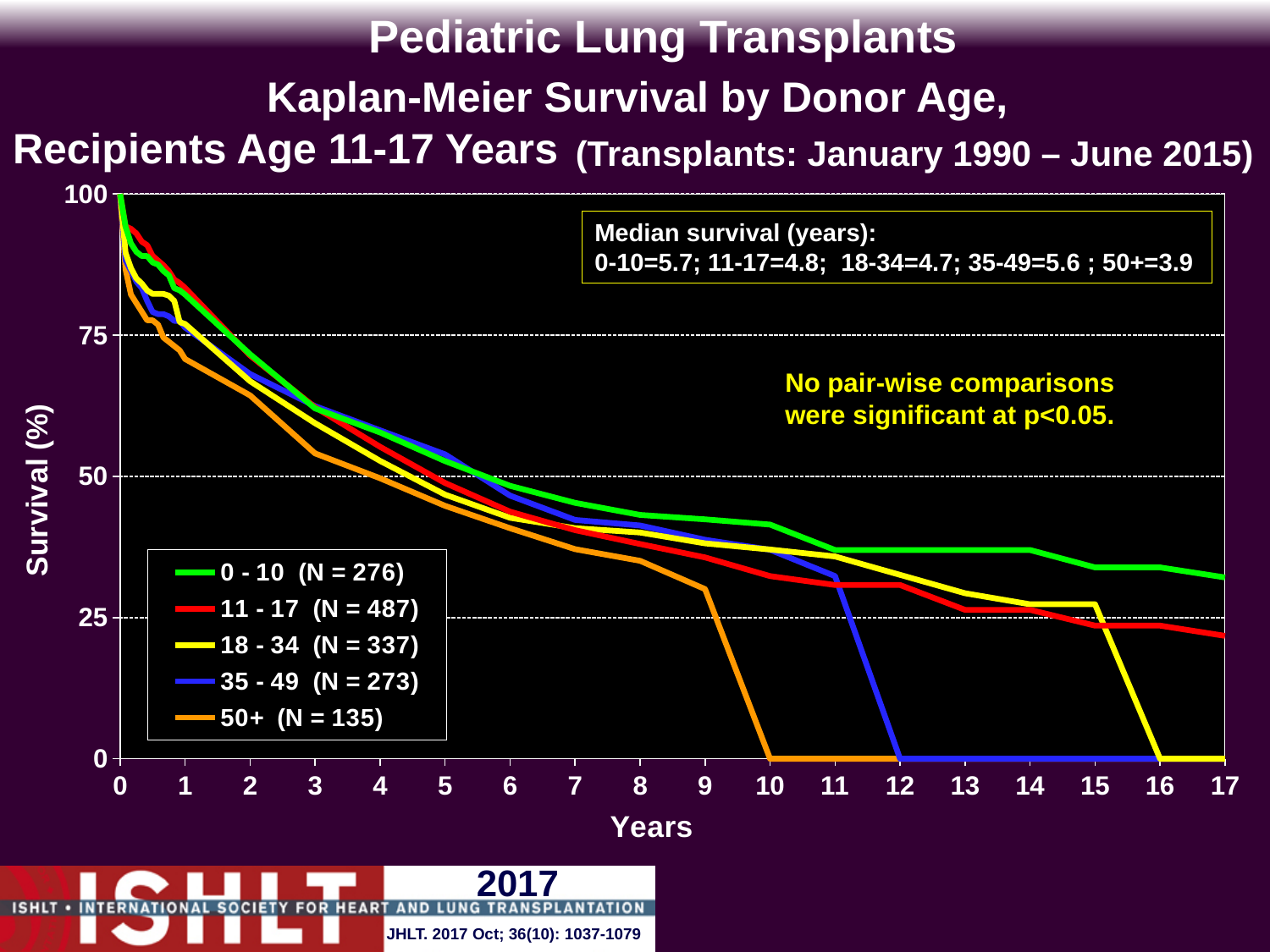
Which donor age group has the highest median survival? 0-10 Which donor age group has the lowest median survival? 50+ What is the difference in median survival (years) between the 0-10 and 50+ donor age groups? 1.8 How many donor age groups (series) does the legend list? 5 How many transplants (N) are in the 11-17 donor age group according to the legend? 487 What kind of chart is shown on the slide? line chart What is the median survival in years for the 50+ donor age group? 3.9 Is the survival for the 0-10 donor age group at 17 years greater or less than 25%? greater What is the median survival in years for the 0-10 donor age group? 5.7 Is the survival for the 50+ donor age group at 9 years greater or less than 50%? less Do the survival curves rise or fall as years increase? fall Which has the larger median survival, the 11-17 or the 18-34 donor age group? 11-17